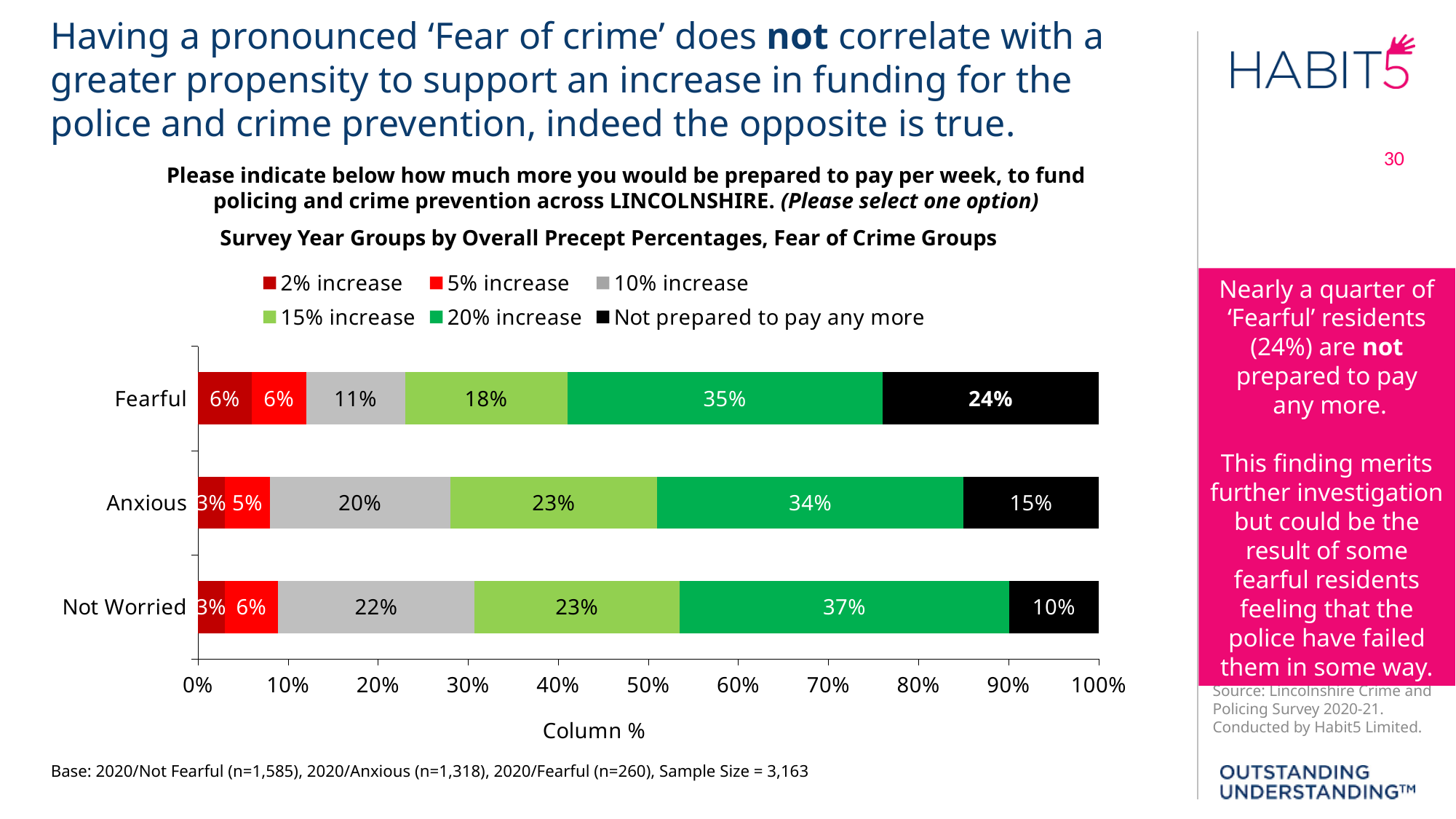
Which group has the lowest percentage choosing a 10% increase? Fearful What percentage of Fearful residents are not prepared to pay any more? 24% Which is larger: the 20% increase value for Not Worried or for Anxious? Not Worried Which fear of crime group has the highest percentage not prepared to pay any more? Fearful What is the value for the 15% increase option among Fearful residents? 18% How many series does the legend list? 6 What is the label on the horizontal axis of the chart? Column % What share of Anxious residents chose a 10% increase? 20% How many fear of crime groups are shown on the chart? 3 What is the difference between the Fearful and Not Worried groups for 'Not prepared to pay any more'? 14% What kind of chart is shown on the slide? Stacked bar chart What is the value for the 20% increase option among Not Worried residents? 37%